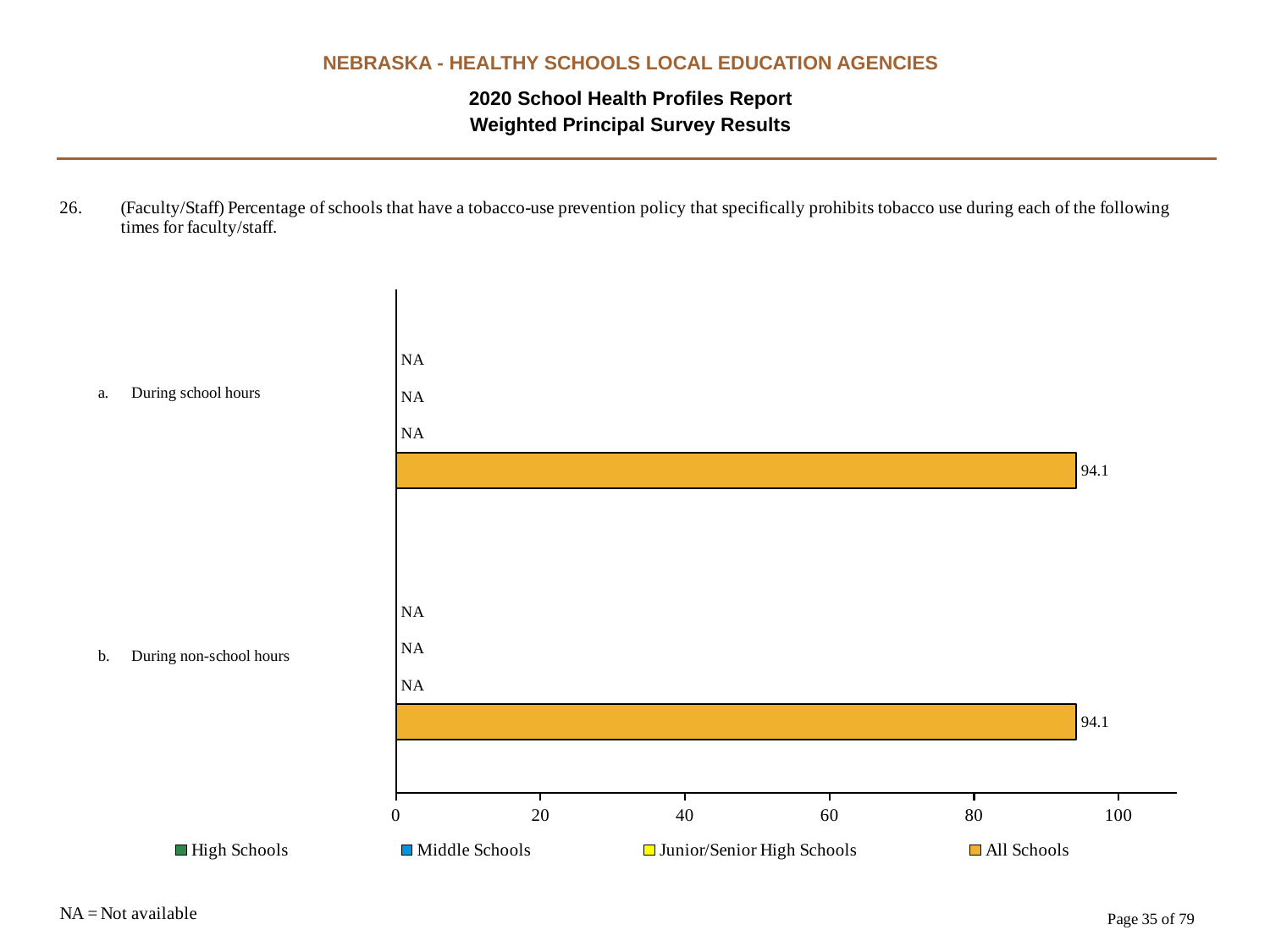
What is shown for Middle Schools for 'During non-school hours'? NA What is the difference between the All Schools values for 'During school hours' and 'During non-school hours'? 0 What does NA stand for according to the note on the slide? Not available Which series is shown in the legend with a yellow marker? Junior/Senior High Schools Is the All Schools value for 'During non-school hours' greater or less than 100? less How many series does the legend list? 4 What kind of chart is this? bar chart What is the value for All Schools for 'During non-school hours'? 94.1 What is shown for High Schools for 'During school hours'? NA Is the All Schools value for 'During school hours' greater or less than 80? greater What is the value for All Schools for 'During school hours'? 94.1 How many categories are shown on the chart? 2